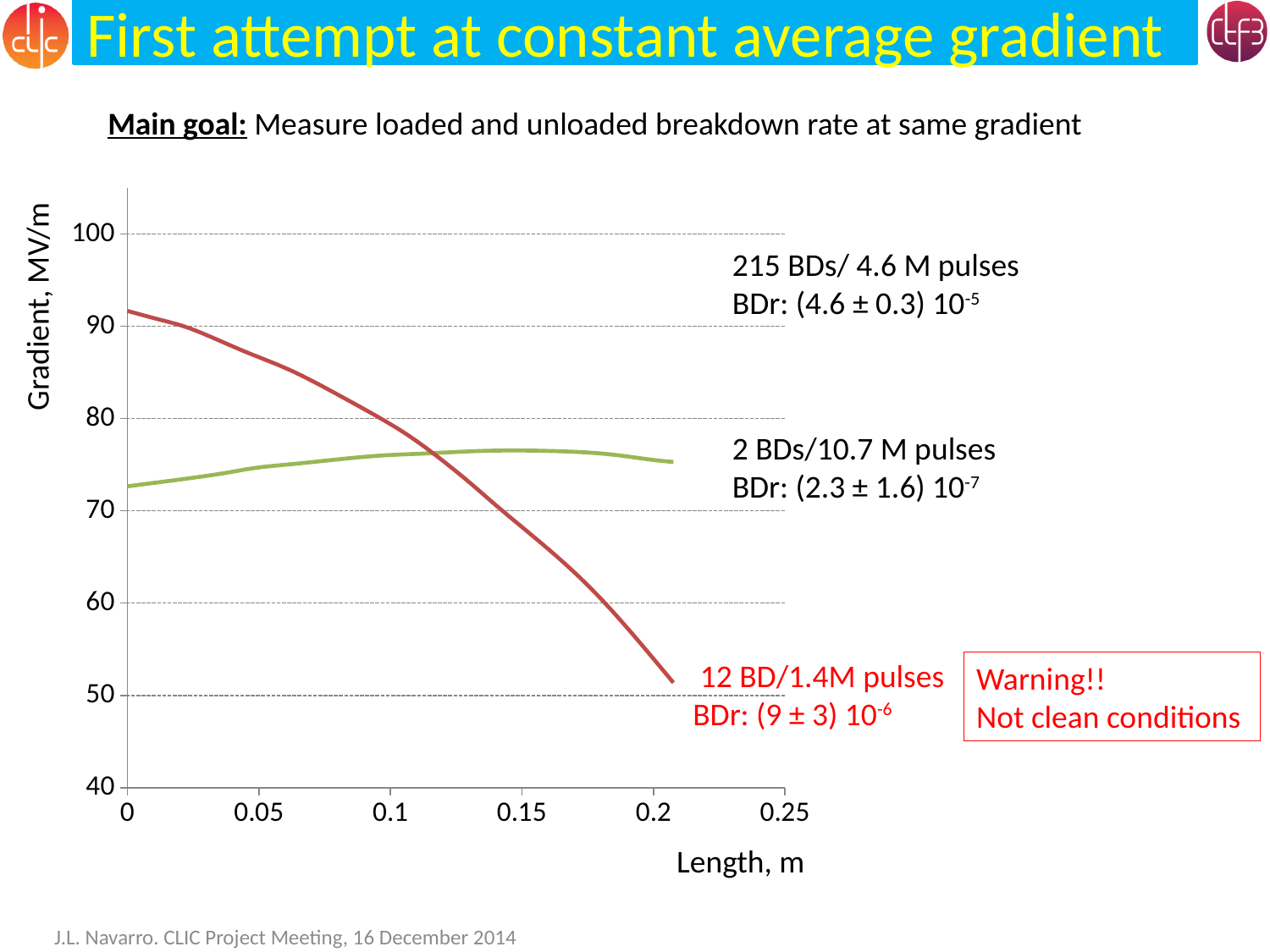
At length 0.2, is the value of the red line greater or less than 60 MV/m? less At length 0, which line has the higher gradient, the red line or the green line? red line At length 0, is the value of the red line greater or less than 80 MV/m? greater At length 0, is the value of the green line greater or less than 70 MV/m? greater What is the highest value shown on the vertical axis? 100 What kind of chart is shown on the slide? line chart What is the label of the horizontal axis? Length, m Does the red line rise or fall as length increases along the x axis? fall What is the label of the vertical axis? Gradient, MV/m At length 0.2, which line has the higher gradient, the red line or the green line? green line How many lines are plotted on the chart? 2